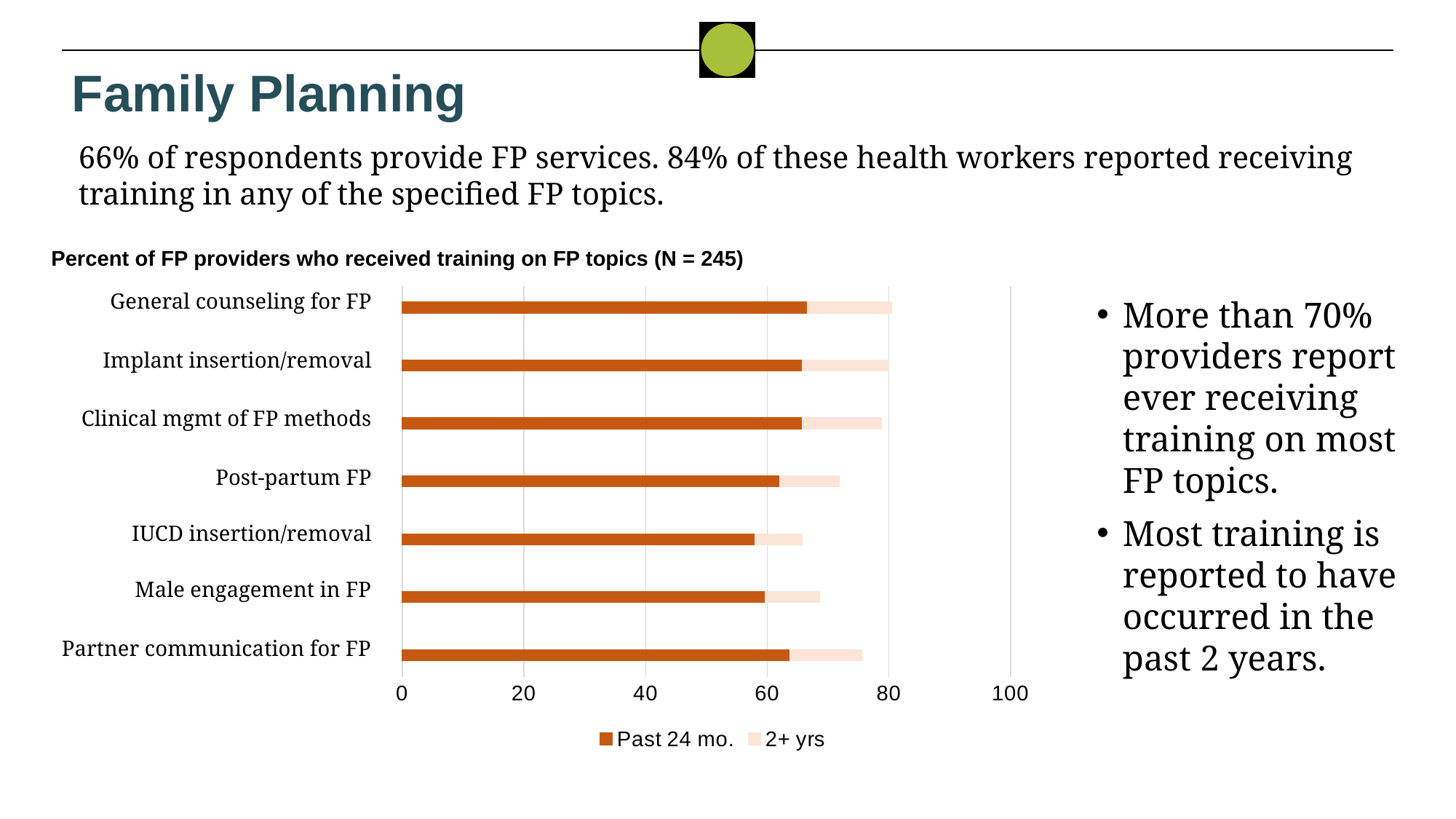
Which has a longer total bar: General counseling for FP or Male engagement in FP? General counseling for FP Is the total bar length for Post-partum FP greater or less than 80? less Which has a longer total bar: Post-partum FP or IUCD insertion/removal? Post-partum FP What are the two series named in the chart legend? Past 24 mo. and 2+ yrs How many FP topics (categories) are shown in the chart? 7 Is the Past 24 mo. value for General counseling for FP greater or less than 60? greater Is the Past 24 mo. value for Clinical mgmt of FP methods greater or less than 40? greater What kind of chart is shown on the slide? bar chart How many series does the chart legend list? 2 What is the title of the chart? Percent of FP providers who received training on FP topics (N = 245)